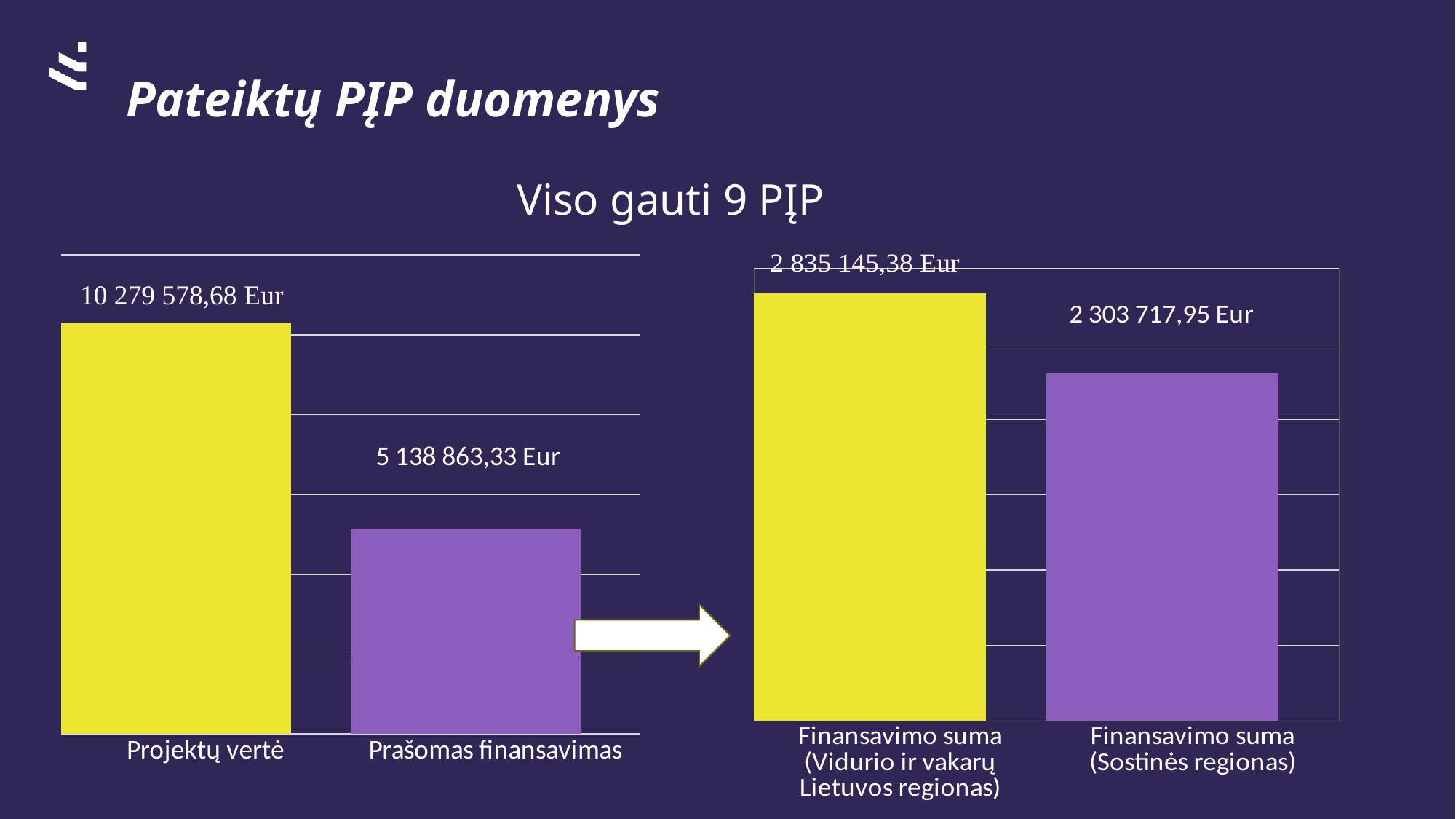
On the left chart, what is the value for Projektų vertė? 10 279 578,68 Eur On the left chart, which category has the highest value? Projektų vertė On the right chart, what is the value for Finansavimo suma (Vidurio ir vakarų Lietuvos regionas)? 2 835 145,38 Eur What colour is the Projektų vertė bar on the left chart? Yellow On the left chart, what is the value for Prašomas finansavimas? 5 138 863,33 Eur What kind of chart is the right chart? Bar chart On the right chart, what is the value for Finansavimo suma (Sostinės regionas)? 2 303 717,95 Eur On the right chart, which is larger: Finansavimo suma (Vidurio ir vakarų Lietuvos regionas) or Finansavimo suma (Sostinės regionas)? Finansavimo suma (Vidurio ir vakarų Lietuvos regionas) On the right chart, which category has the lowest value? Finansavimo suma (Sostinės regionas) On the right chart, what is the difference between the Vidurio ir vakarų Lietuvos regionas value and the Sostinės regionas value? 531 427,43 Eur On the left chart, what is the difference between Projektų vertė and Prašomas finansavimas? 5 140 715,35 Eur How many categories does the left chart show? 2